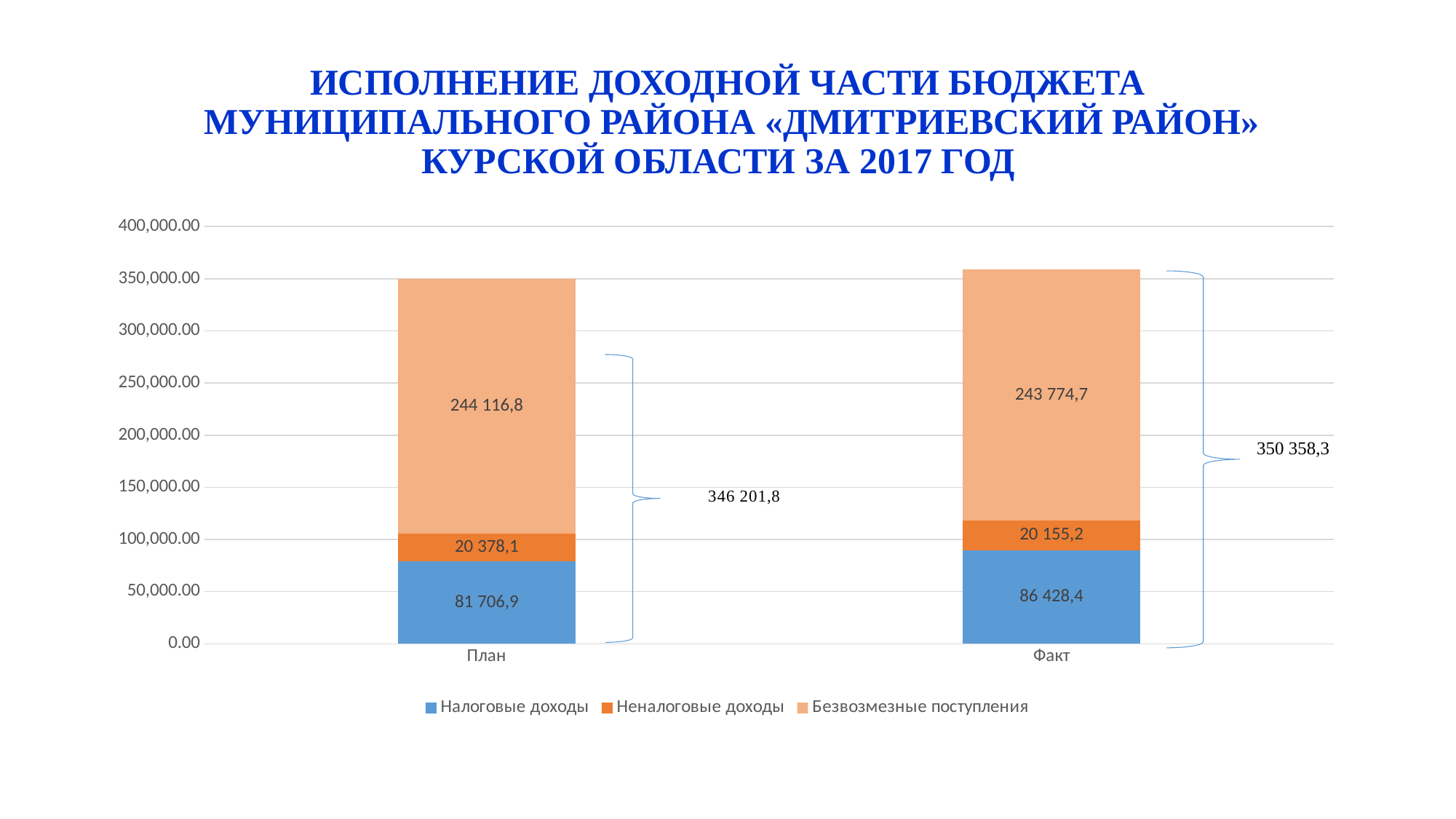
What is the value of Безвозмезные поступления for Факт? 243 774,7 What kind of chart is shown on the slide? Stacked bar chart What is the value of Неналоговые доходы for Факт? 20 155,2 What is the difference between Неналоговые доходы for План and for Факт? 222,9 How many series does the legend list? 3 What is the value of Налоговые доходы for План? 81 706,9 How many categories are shown on the x axis? 2 What is the total of the stacked bar for План? 346 201,8 Which is larger, Налоговые доходы for План or for Факт? Факт What is the total of the stacked bar for Факт? 350 358,3 What is the difference between Налоговые доходы for Факт and for План? 4 721,5 Which series has the largest value in the План bar? Безвозмезные поступления